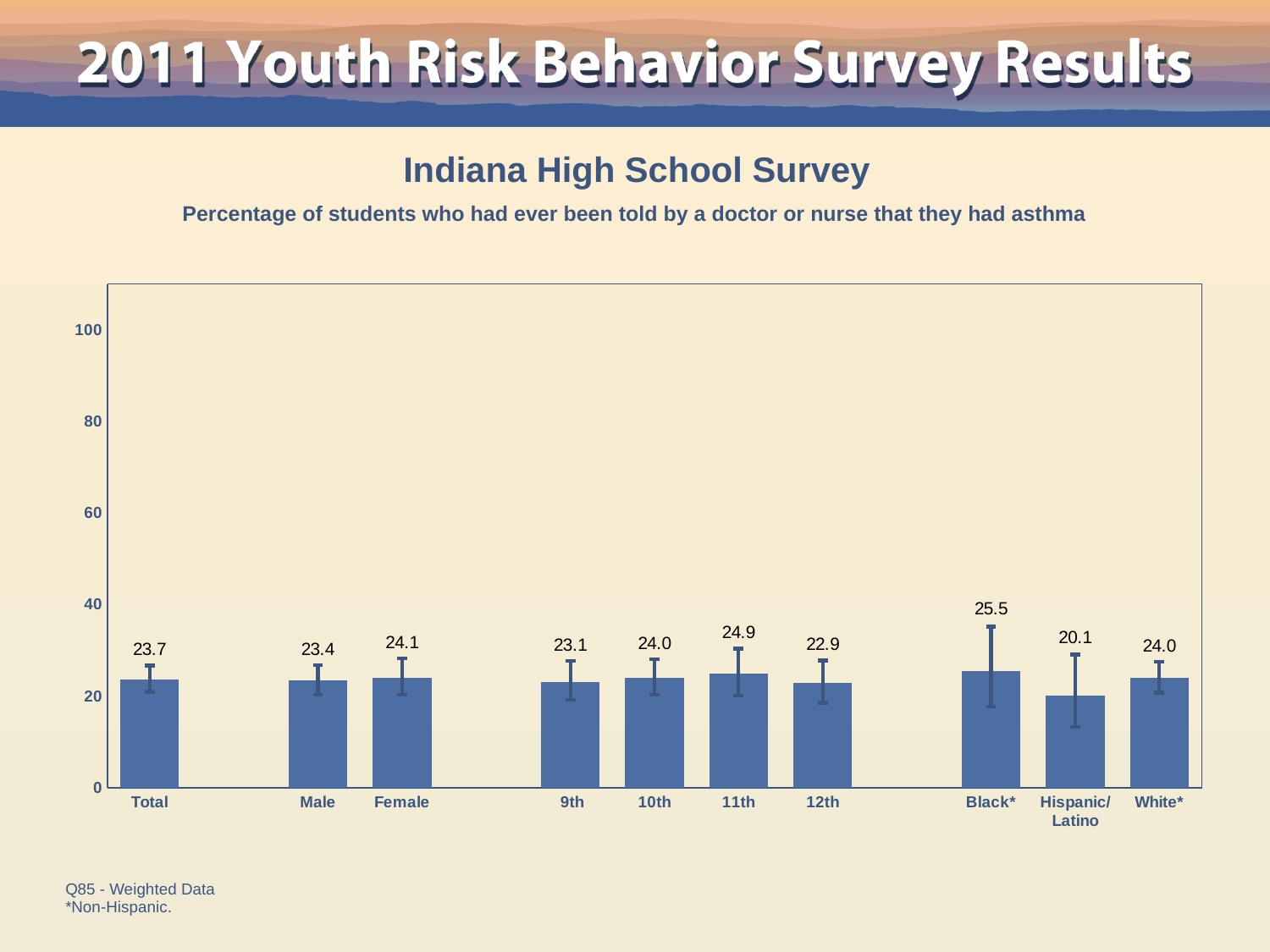
How many bars are shown in the chart? 10 Which category has the lowest value? Hispanic/Latino Which is larger, the value for 11th or the value for 12th? 11th What is the value for Hispanic/Latino? 20.1 What is the difference between the values for Female and Male? 0.7 What is the chart's subtitle describing the measured percentage? Percentage of students who had ever been told by a doctor or nurse that they had asthma What is the value for 11th? 24.9 What is the value for Total? 23.7 Which category has the highest value? Black* Is the value for White* greater or less than 40? less What is the difference between the values for Black* and Hispanic/Latino? 5.4 What kind of chart is shown on the slide? bar chart